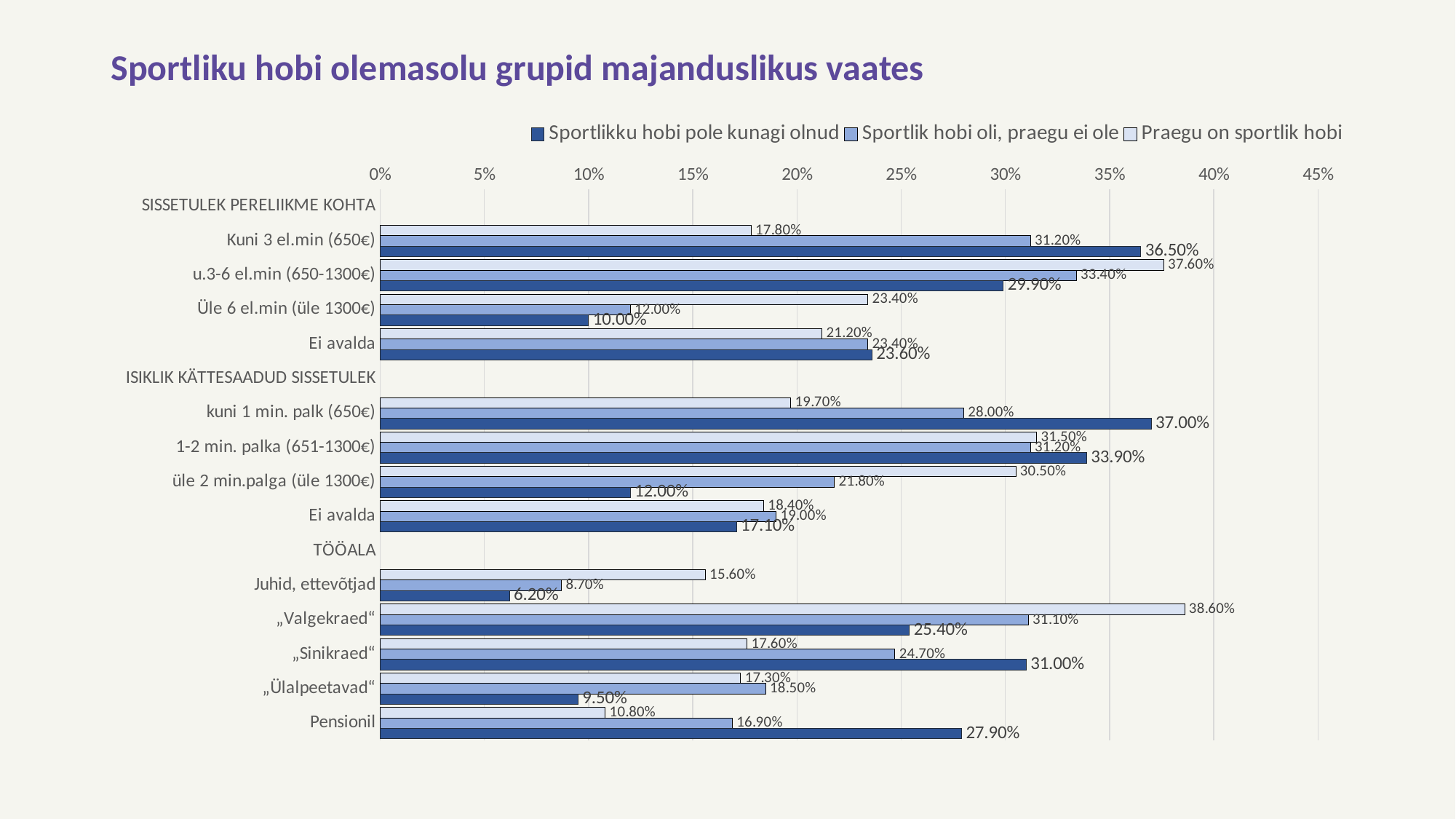
What is the value of "Sportlikku hobi pole kunagi olnud" for "Kuni 3 el.min (650€)"? 36.50% What is the value of "Praegu on sportlik hobi" for "„Valgekraed“"? 38.60% Which category has the lowest value for "Sportlikku hobi pole kunagi olnud"? Juhid, ettevõtjad Which category has the highest value for "Praegu on sportlik hobi"? „Valgekraed“ What is the difference between "Sportlikku hobi pole kunagi olnud" and "Praegu on sportlik hobi" for "kuni 1 min. palk (650€)"? 17.30% What is the title of the chart? Sportliku hobi olemasolu grupid majanduslikus vaates For "Üle 6 el.min (üle 1300€)", which is larger: "Praegu on sportlik hobi" or "Sportlikku hobi pole kunagi olnud"? Praegu on sportlik hobi How many series does the legend list? 3 Is the value of "Sportlikku hobi pole kunagi olnud" for "„Sinikraed“" greater or less than 30%? greater What type of chart is shown on the slide? bar chart What is the value of "Praegu on sportlik hobi" for "üle 2 min.palga (üle 1300€)"? 30.50% What is the value of "Sportlik hobi oli, praegu ei ole" for "Pensionil"? 16.90%